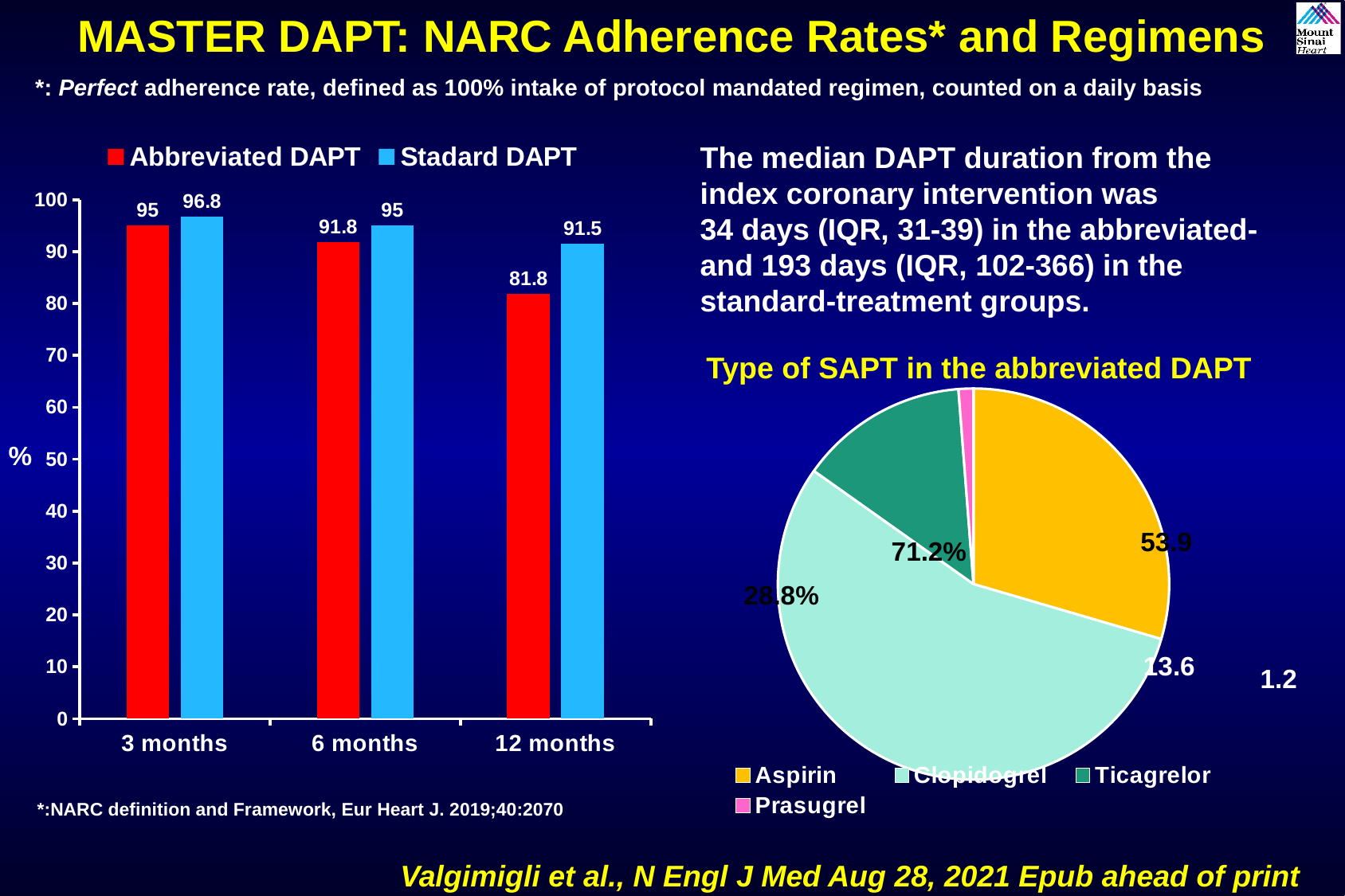
In the bar chart on the left, what is the adherence rate for Abbreviated DAPT at 3 months? 95 In the bar chart on the left, which time point has the lowest Abbreviated DAPT adherence rate? 12 months In the bar chart on the left, what is the adherence rate for Abbreviated DAPT at 12 months? 81.8 In the bar chart on the left, which time point has the highest Standard DAPT adherence rate? 3 months In the pie chart titled 'Type of SAPT in the abbreviated DAPT', how many drugs does the legend list? 4 In the pie chart titled 'Type of SAPT in the abbreviated DAPT', which drug has the largest slice? Clopidogrel In the bar chart on the left, how many series does the legend list? 2 In the bar chart on the left, does the Abbreviated DAPT adherence rate rise or fall from 3 months to 12 months? fall In the bar chart on the left, what is the adherence rate for Standard DAPT at 12 months? 91.5 In the bar chart on the left, how many time-point categories are shown on the x axis? 3 In the bar chart on the left, what is the adherence rate for Standard DAPT at 6 months? 95 In the bar chart on the left, what is the difference between the Standard DAPT and Abbreviated DAPT adherence rates at 12 months? 9.7